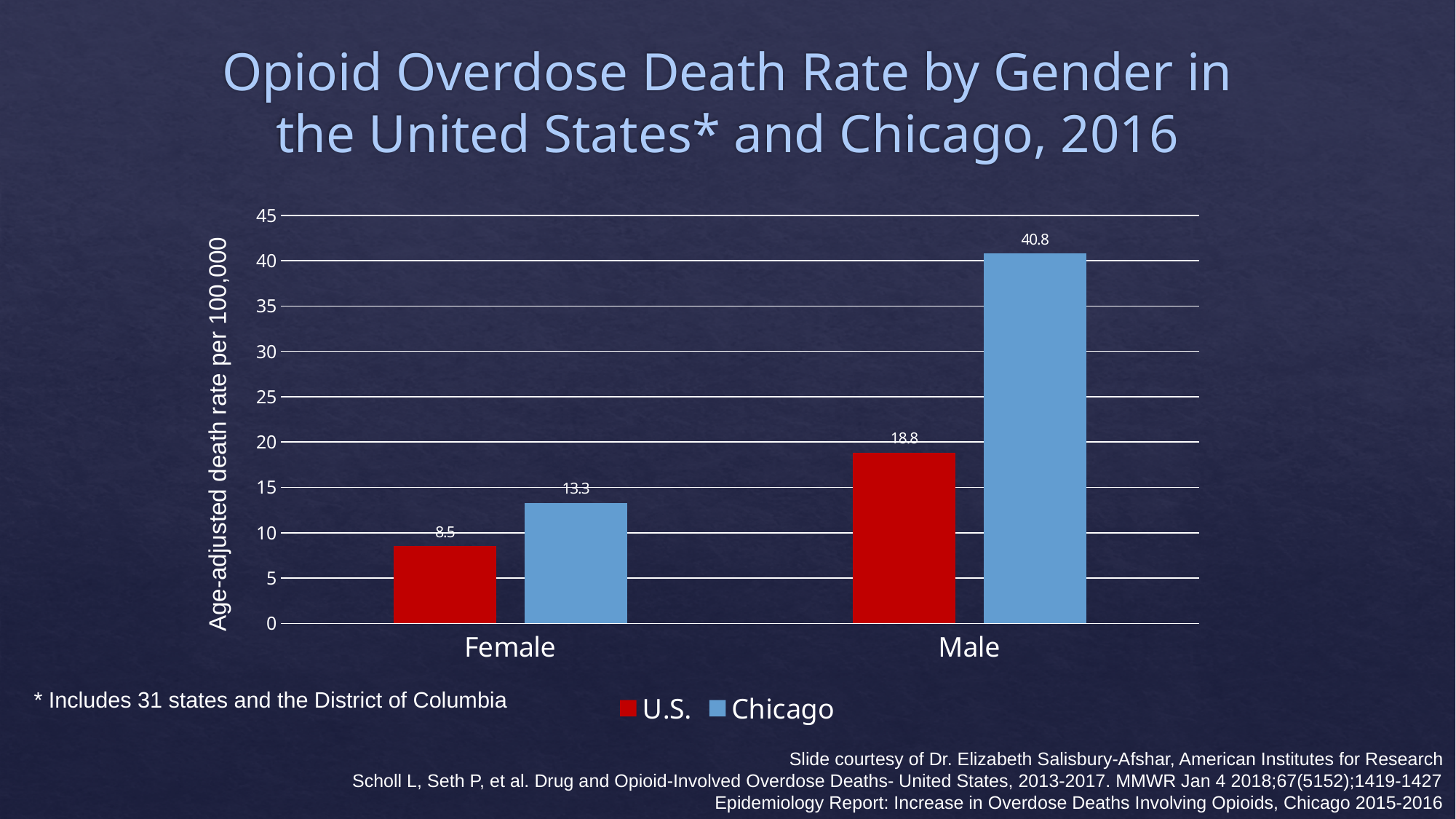
Is the Chicago male death rate greater or less than 40? greater How many gender categories are shown on the x axis? 2 What is the age-adjusted opioid overdose death rate for females in the U.S.? 8.5 Which bar shows the highest death rate on the chart? Chicago, Male What is the difference between the Chicago and U.S. death rates for females? 4.8 Which is larger, the U.S. male death rate or the Chicago female death rate? U.S. male death rate How many series does the legend list? 2 What type of chart is shown on the slide? Bar chart What is the difference between the Chicago and U.S. death rates for males? 22 What is the age-adjusted opioid overdose death rate for males in the U.S.? 18.8 What is the age-adjusted opioid overdose death rate for females in Chicago? 13.3 Which bar shows the lowest death rate on the chart? U.S., Female